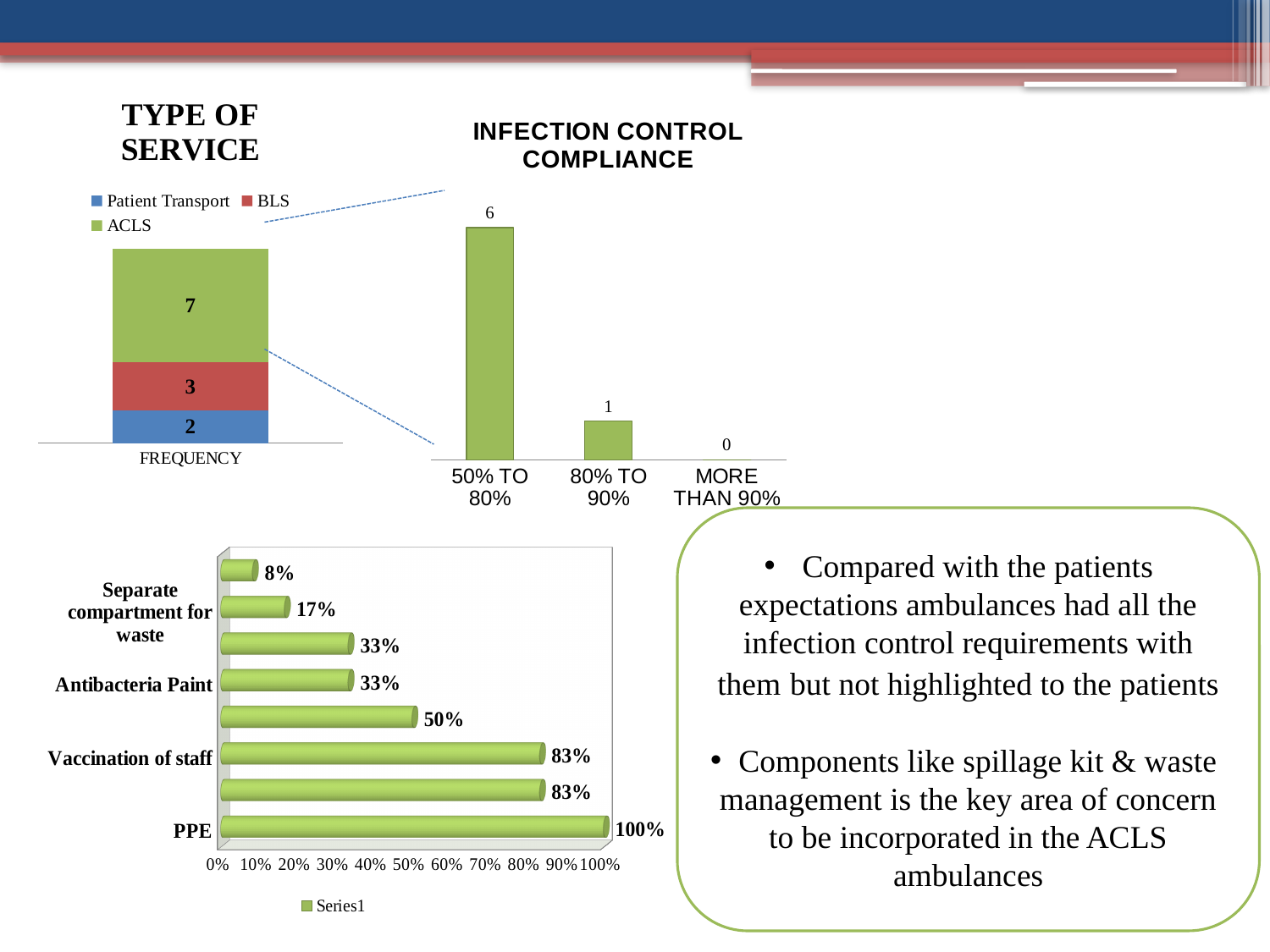
In the bottom-left chart, what is the value for Vaccination of staff? 83% In the INFECTION CONTROL COMPLIANCE chart, how many categories are shown on the x axis? 3 In the bottom-left chart, which is larger, the value for Antibacteria Paint or the value for Separate compartment for waste? Antibacteria Paint In the TYPE OF SERVICE chart, what is the value for ACLS? 7 In the TYPE OF SERVICE chart, what is the value for Patient Transport? 2 In the INFECTION CONTROL COMPLIANCE chart, what is the difference between the values for 50% TO 80% and 80% TO 90%? 5 In the TYPE OF SERVICE chart, what is the total of the stacked bar? 12 In the bottom-left chart, what is the value for PPE? 100% In the TYPE OF SERVICE chart, how many series does the legend list? 3 In the INFECTION CONTROL COMPLIANCE chart, what is the value for 50% TO 80%? 6 In the INFECTION CONTROL COMPLIANCE chart, which category has the lowest value? MORE THAN 90% In the TYPE OF SERVICE chart, which series has the largest value? ACLS